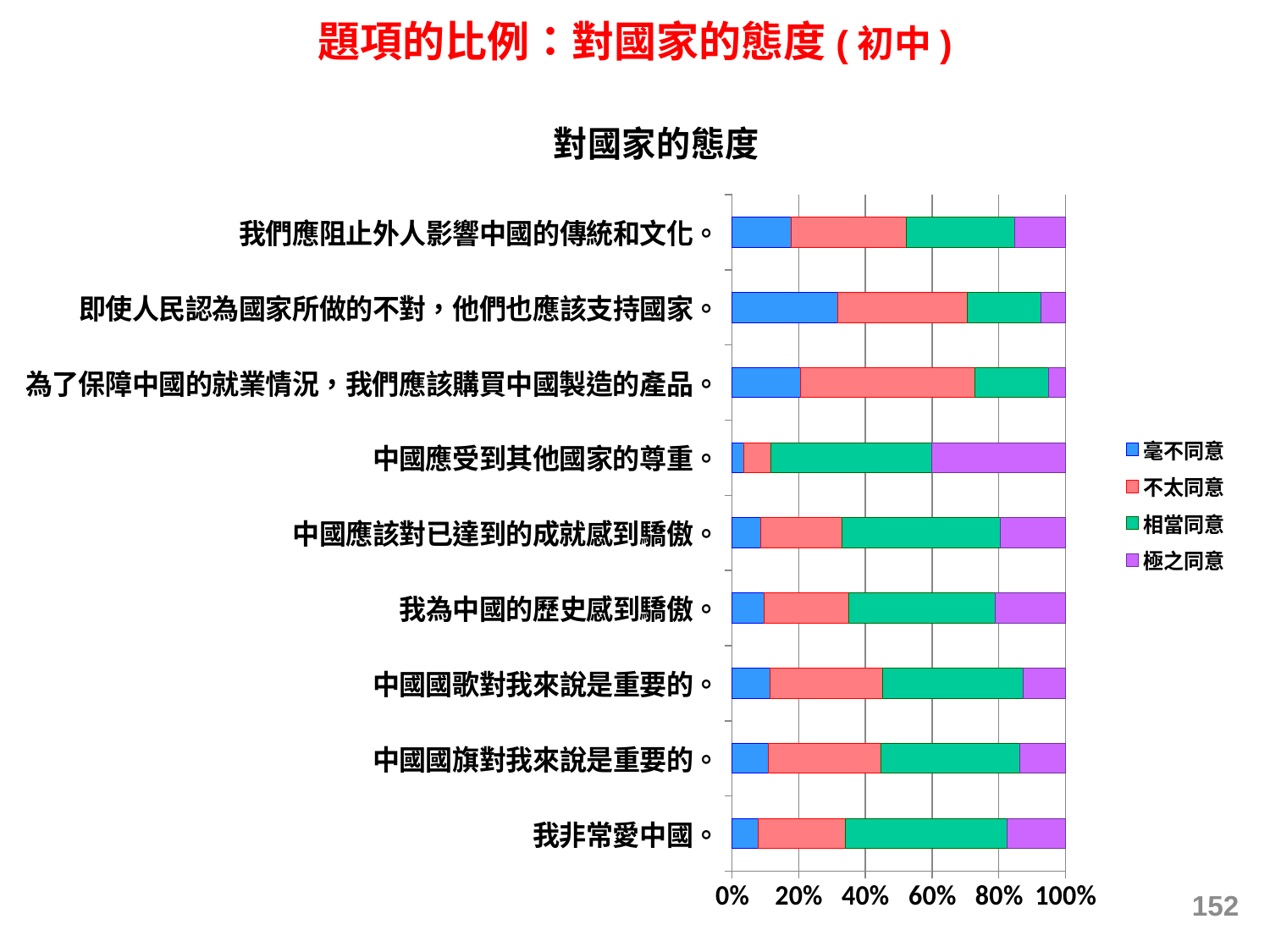
Which statement has the smallest 毫不同意 segment? 中國應受到其他國家的尊重。 What is the title of the chart? 對國家的態度 Is the 毫不同意 share for 中國應受到其他國家的尊重。 greater or less than 20%? less Which statement has the largest 毫不同意 segment? 即使人民認為國家所做的不對，他們也應該支持國家。 Which legend entry is shown in purple? 極之同意 How many statements (categories) are plotted in the chart? 9 Is the 毫不同意 share for 即使人民認為國家所做的不對，他們也應該支持國家。 greater or less than 20%? greater What kind of chart is shown on the slide? Stacked bar chart Which is larger: the 極之同意 share for 中國應受到其他國家的尊重。 or for 我們應阻止外人影響中國的傳統和文化。? 中國應受到其他國家的尊重。 Which statement has the largest 極之同意 segment? 中國應受到其他國家的尊重。 How many series does the legend list? 4 Which statement has the largest 不太同意 segment? 為了保障中國的就業情況，我們應該購買中國製造的產品。